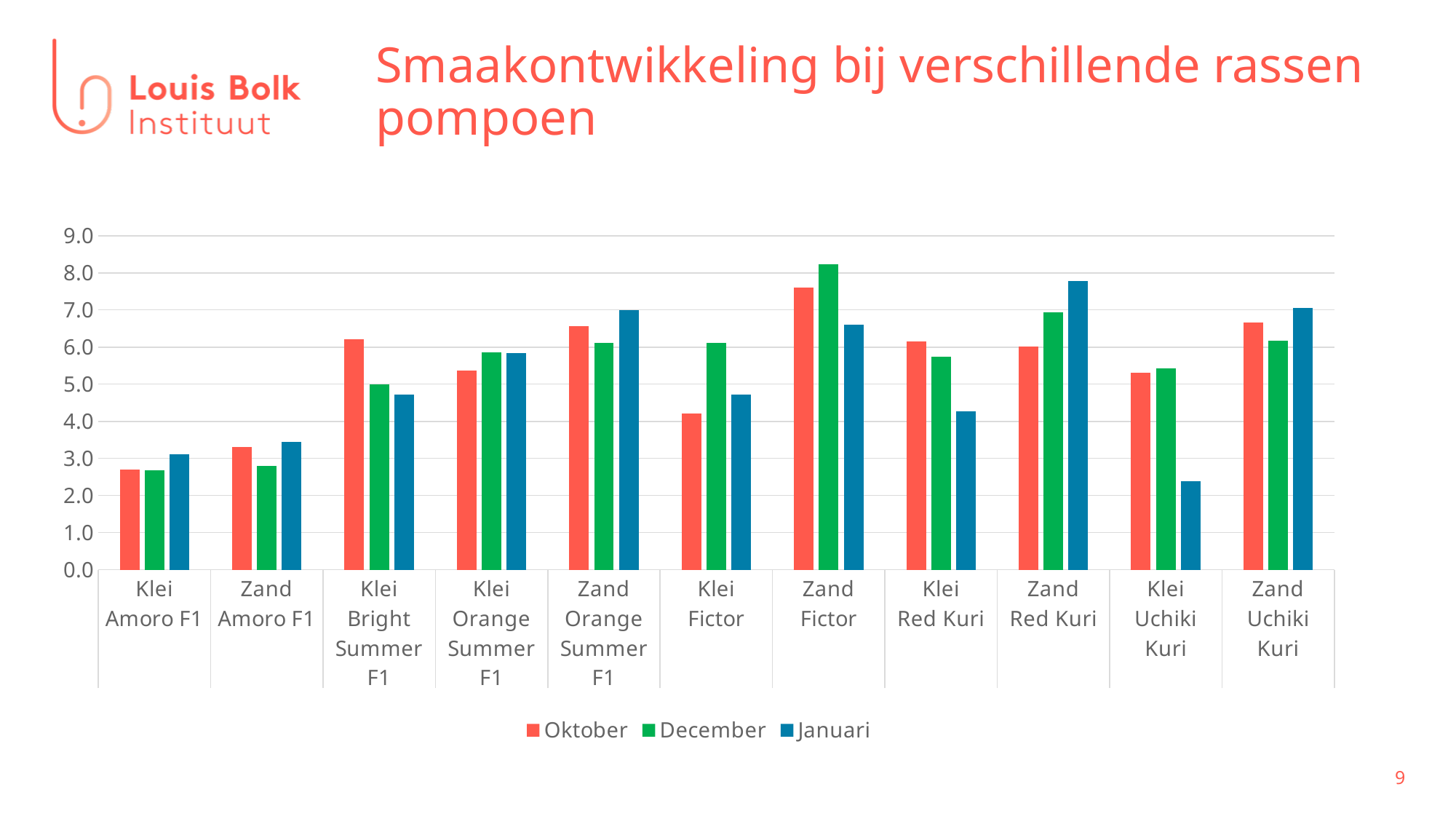
Which category has the highest Januari value? Zand Red Kuri Is the Januari value for Klei Uchiki Kuri greater or less than 3.0? less How many series does the legend list? 3 What is the title of the chart slide? Smaakontwikkeling bij verschillende rassen pompoen Which category has the highest December value? Zand Fictor Which category has the lowest Oktober value? Klei Amoro F1 Which category has the lowest Januari value? Klei Uchiki Kuri For Klei Fictor, which is larger: the Oktober value or the December value? December Is the December value for Zand Fictor greater or less than 8.0? greater What kind of chart is shown on the slide? bar chart How many categories (variety/soil combinations) are shown on the x axis? 11 Is the Oktober value for Klei Bright Summer F1 greater or less than 6.0? greater